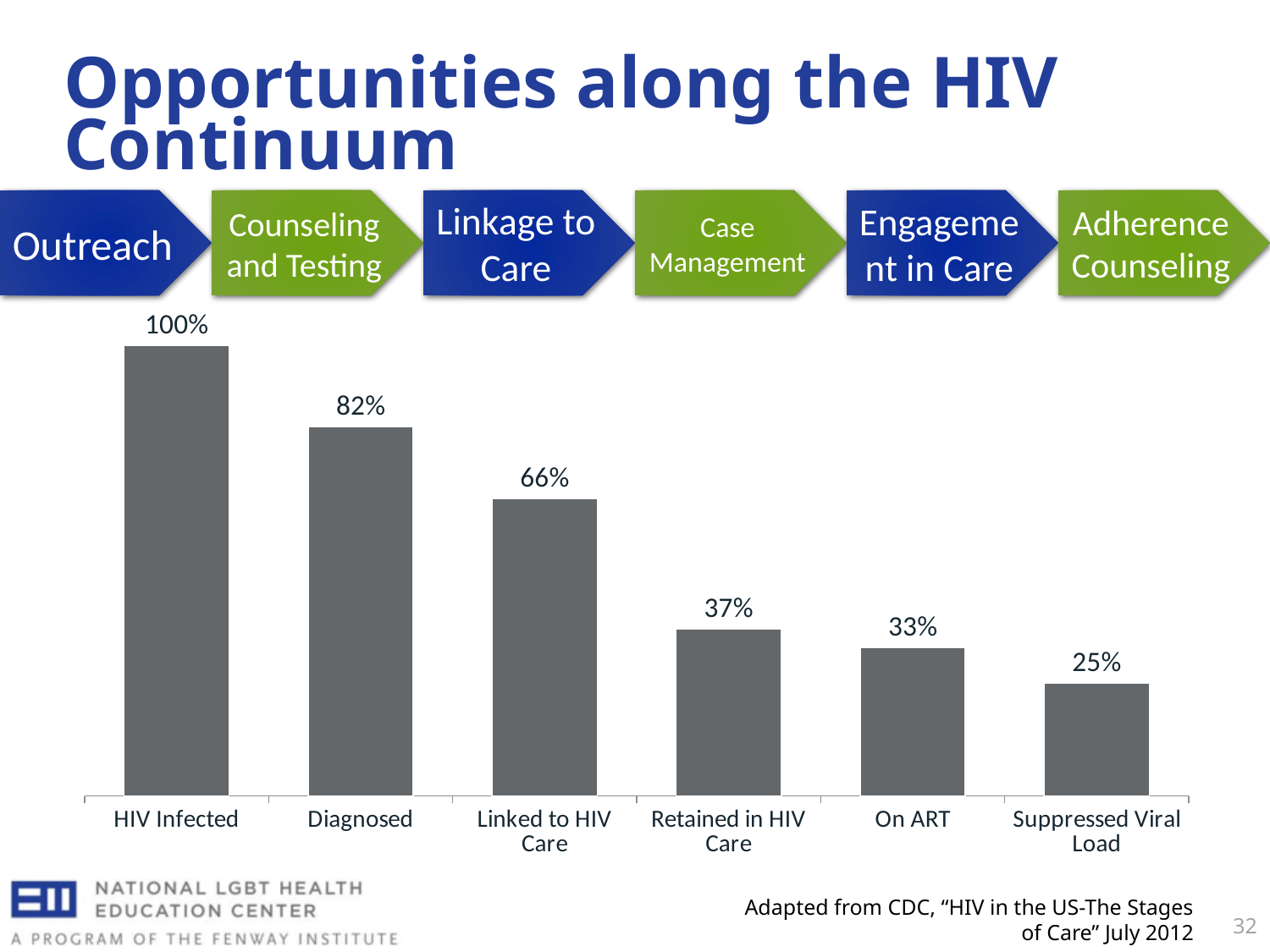
What is the value for Linked to HIV Care? 66% Which is larger, the value for Retained in HIV Care or the value for On ART? Retained in HIV Care Which category has the lowest value? Suppressed Viral Load What kind of chart is shown on the slide? Bar chart Which category has the highest value? HIV Infected What is the difference between the values for Diagnosed and Linked to HIV Care? 16% Do the values rise or fall from left to right along the x axis? Fall What is the value for Suppressed Viral Load? 25% What is the value for Diagnosed? 82% What is the value for Retained in HIV Care? 37% How many categories are shown on the chart? 6 What is the value for On ART? 33%